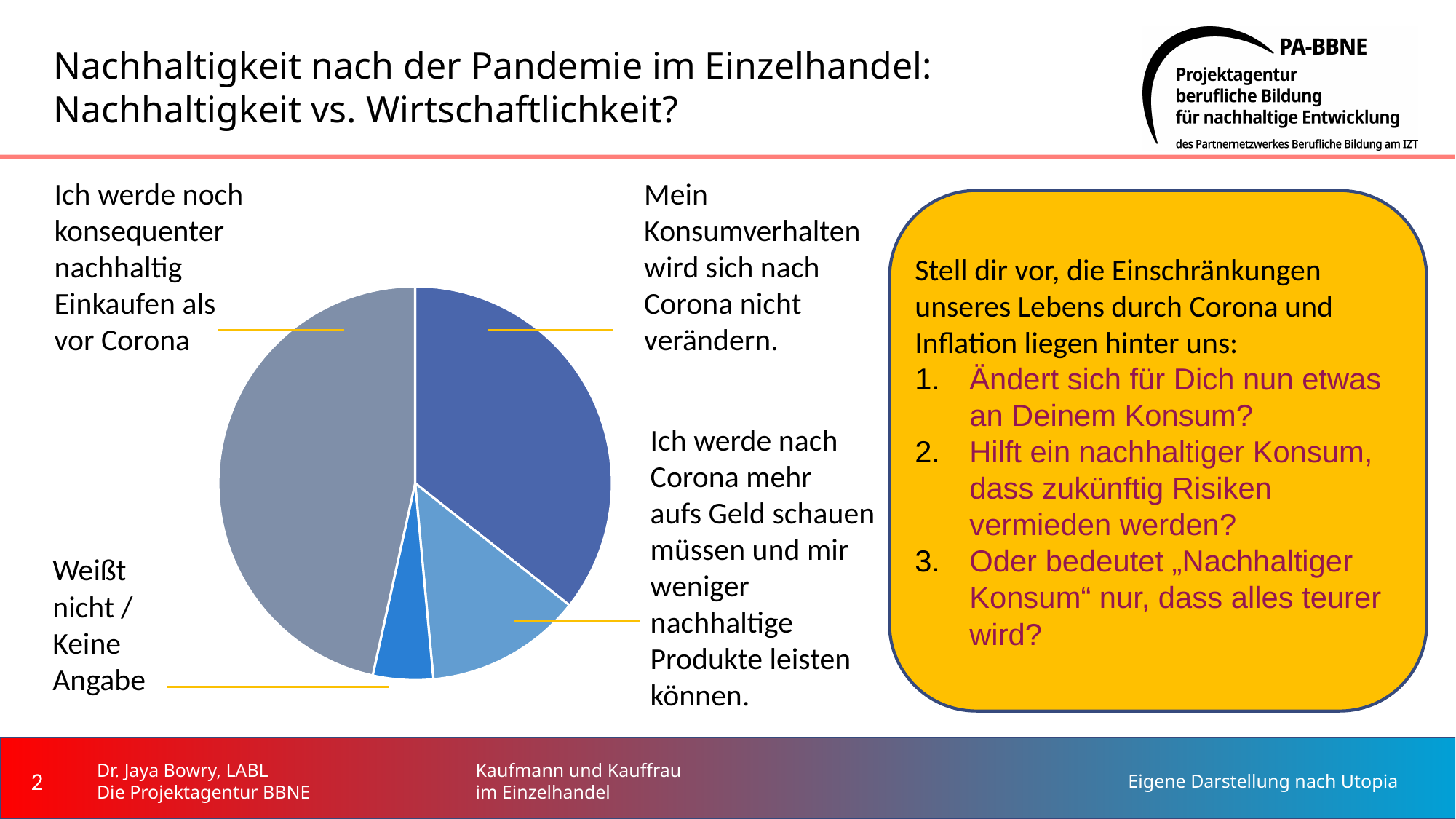
How many slices does the pie chart have? 4 Which slice is larger: "Mein Konsumverhalten wird sich nach Corona nicht verändern" or "Weißt nicht / Keine Angabe"? Mein Konsumverhalten wird sich nach Corona nicht verändern What colour is the slice for "Ich werde noch konsequenter nachhaltig Einkaufen als vor Corona" in the pie chart? grey Which category has the largest slice in the pie chart? Ich werde noch konsequenter nachhaltig Einkaufen als vor Corona What kind of chart is shown on the slide? pie chart Which category has the smallest slice in the pie chart? Weißt nicht / Keine Angabe Which slice is larger: "Ich werde noch konsequenter nachhaltig Einkaufen als vor Corona" or "Ich werde nach Corona mehr aufs Geld schauen müssen und mir weniger nachhaltige Produkte leisten können"? Ich werde noch konsequenter nachhaltig Einkaufen als vor Corona Which slice is larger: "Ich werde nach Corona mehr aufs Geld schauen müssen und mir weniger nachhaltige Produkte leisten können" or "Weißt nicht / Keine Angabe"? Ich werde nach Corona mehr aufs Geld schauen müssen und mir weniger nachhaltige Produkte leisten können What colour is the slice for "Weißt nicht / Keine Angabe" in the pie chart? bright blue